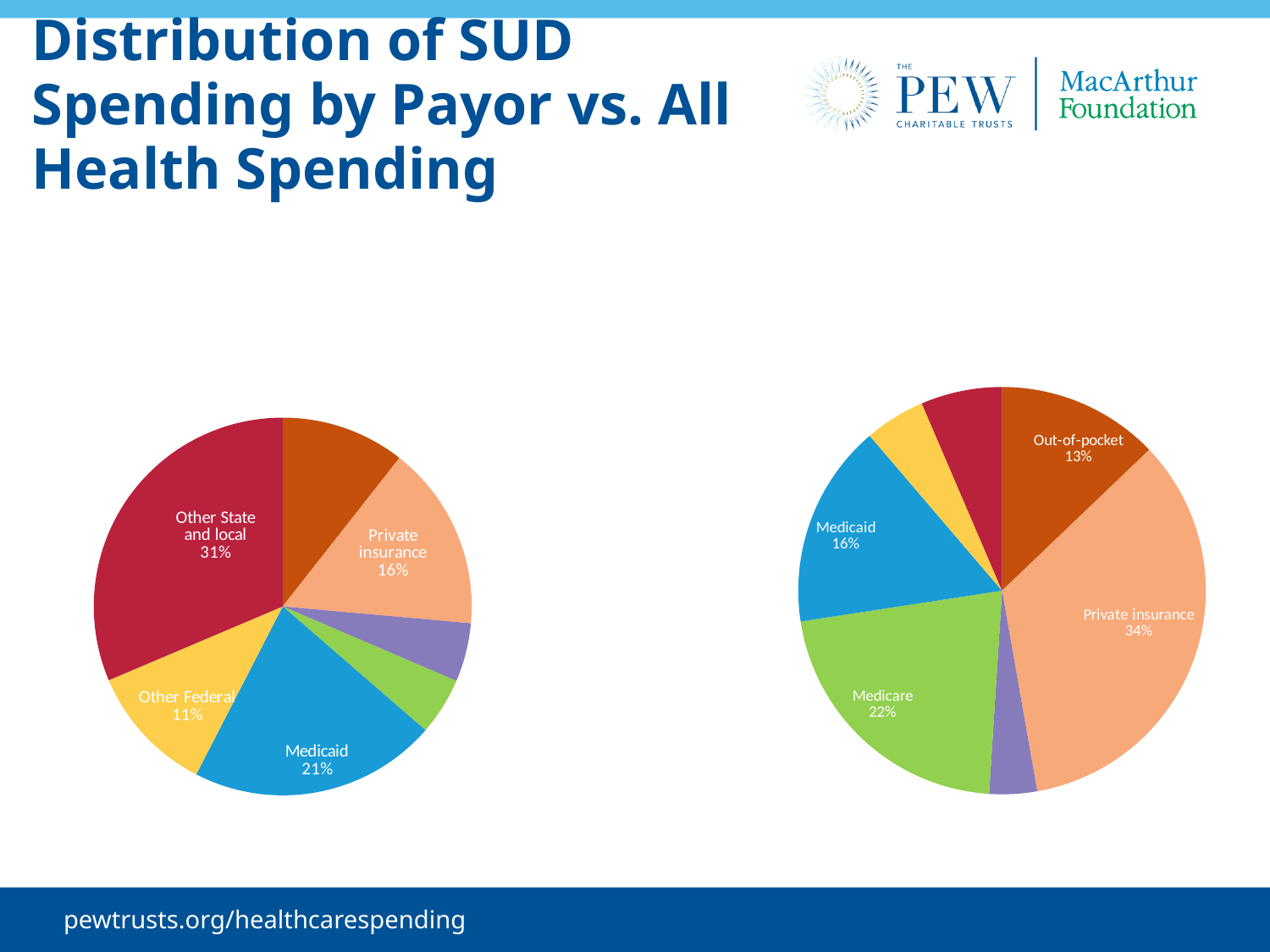
In the left pie chart, what share is labeled for Medicaid? 21% In the right pie chart, what share is labeled for Medicare? 22% In the left pie chart, what share is labeled for Other Federal? 11% In the right pie chart, what share is labeled for Out-of-pocket? 13% In the right pie chart, which is larger: Medicare or Medicaid? Medicare In the right pie chart, which labeled category has the largest share? Private insurance How many slices does the right pie chart have? 7 In the left pie chart, how many percentage points larger is Medicaid than Private insurance? 5 percentage points In the left pie chart, what share is labeled for Other State and local? 31% In the right pie chart, what share is labeled for Private insurance? 34% In the left pie chart, which labeled category has the largest share? Other State and local What type of chart is shown on the left side of the slide? Pie chart